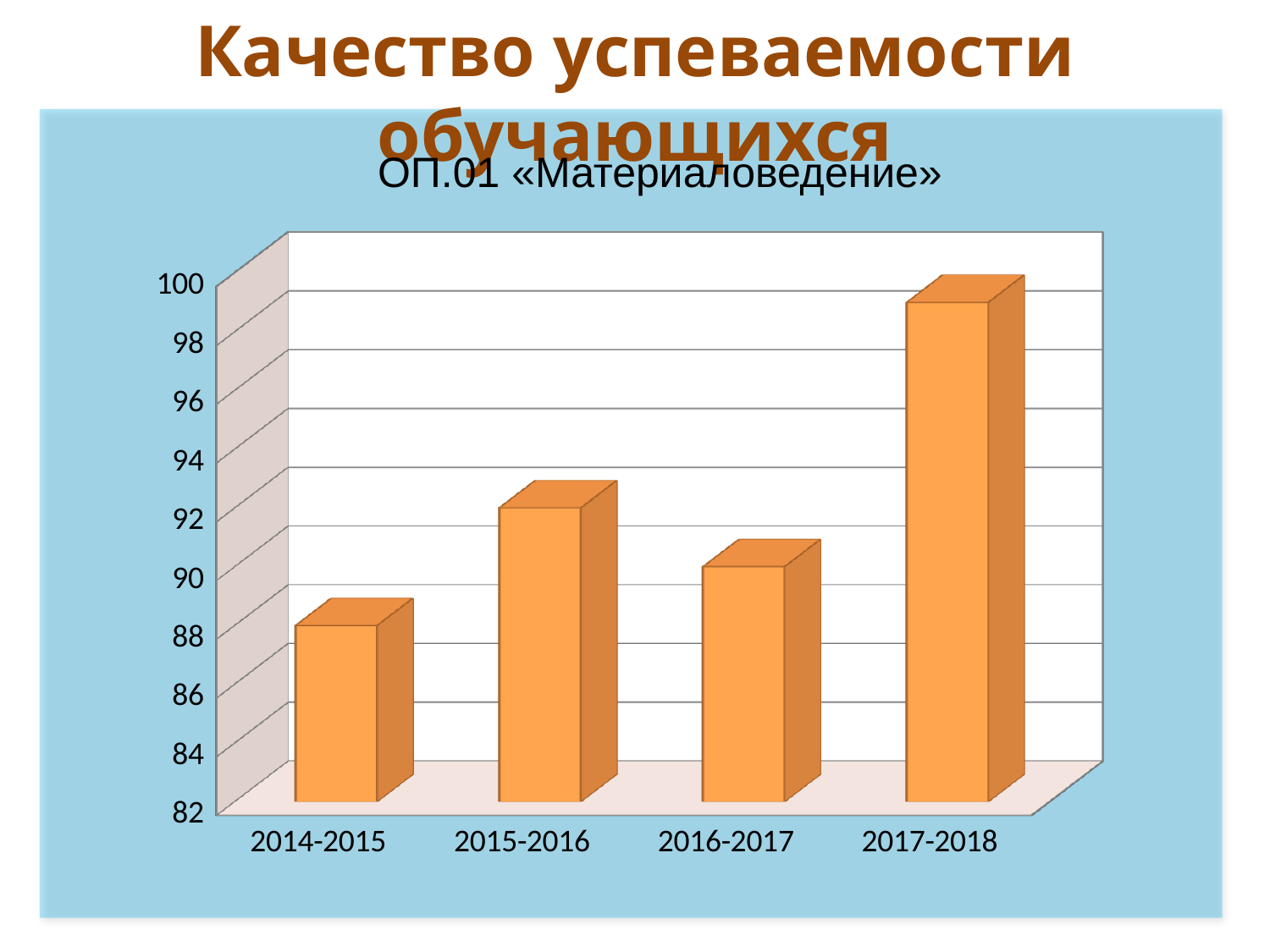
How many academic years are shown on the x axis of the chart? 4 Which academic year has the lowest value in the chart? 2014-2015 Is the value for 2014-2015 greater or less than 90? less Does the value rise or fall from 2015-2016 to 2016-2017? fall What kind of chart is shown on the slide? bar chart Is the value for 2015-2016 greater or less than 90? greater Does the value rise or fall from 2016-2017 to 2017-2018? rise Is the value for 2016-2017 greater or less than 92? less Which is larger, the value for 2015-2016 or the value for 2016-2017? 2015-2016 Which academic year has the highest value in the chart? 2017-2018 What is the title of the chart? ОП.01 «Материаловедение»